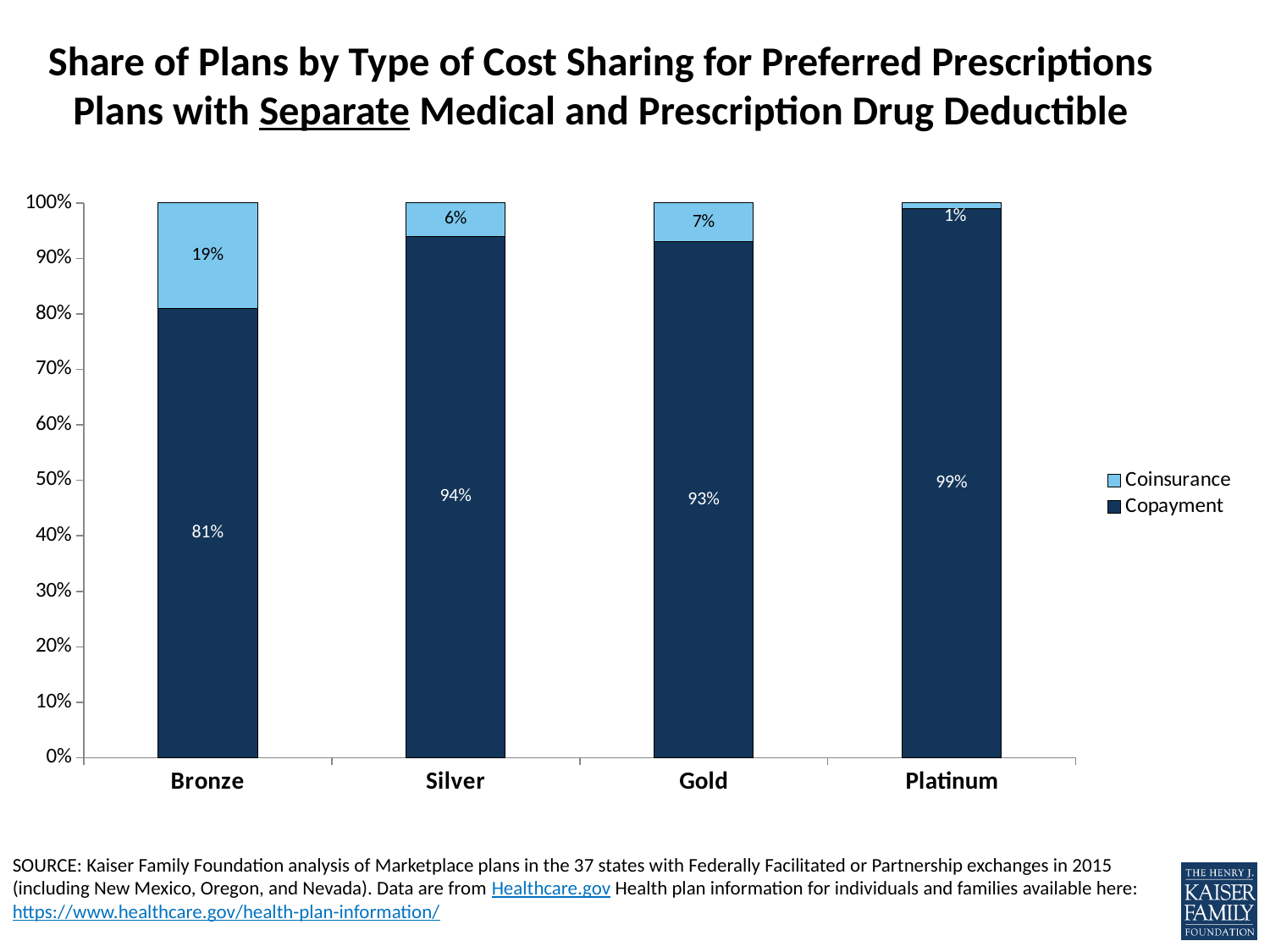
What kind of chart is shown on the slide? Stacked bar chart What is the Coinsurance share for Gold plans? 7% Which plan type has the highest Coinsurance share? Bronze What is the difference between the Copayment shares for Platinum and Bronze plans? 18% What is the Coinsurance share for Silver plans? 6% Does the Copayment share rise or fall from Bronze to Platinum? Rise How many plan types are shown on the x axis? 4 Which plan type has the lowest Copayment share? Bronze What is the Copayment share for Platinum plans? 99% Which is larger, the Copayment share for Silver or for Gold? Silver What is the Copayment share for Bronze plans? 81% How many series does the legend list? 2